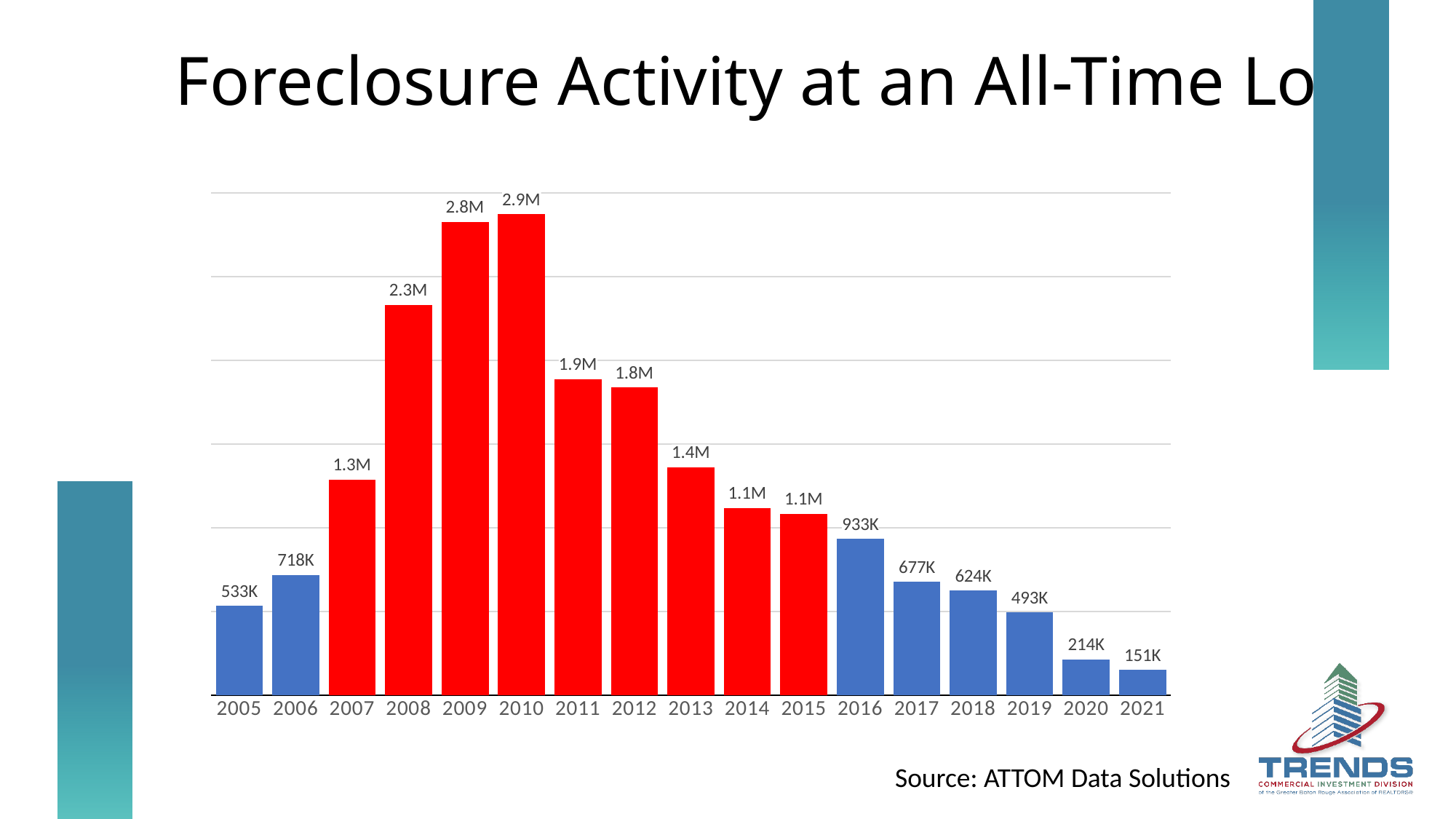
Which year has the lowest foreclosure activity? 2021 Do the values rise or fall from 2010 to 2021? Fall What is the difference between the values for 2020 and 2021? 63K Which years are shown with red bars? 2007 through 2015 What is the value shown for 2021? 151K What value is labeled on the bar for 2016? 933K What is the foreclosure activity value shown for 2010? 2.9M Which year has the highest foreclosure activity? 2010 Which year has the larger value, 2008 or 2011? 2008 What is the difference between the values for 2006 and 2005? 185K How many years are shown on the x axis of the chart? 17 What kind of chart is shown on the slide? Bar chart